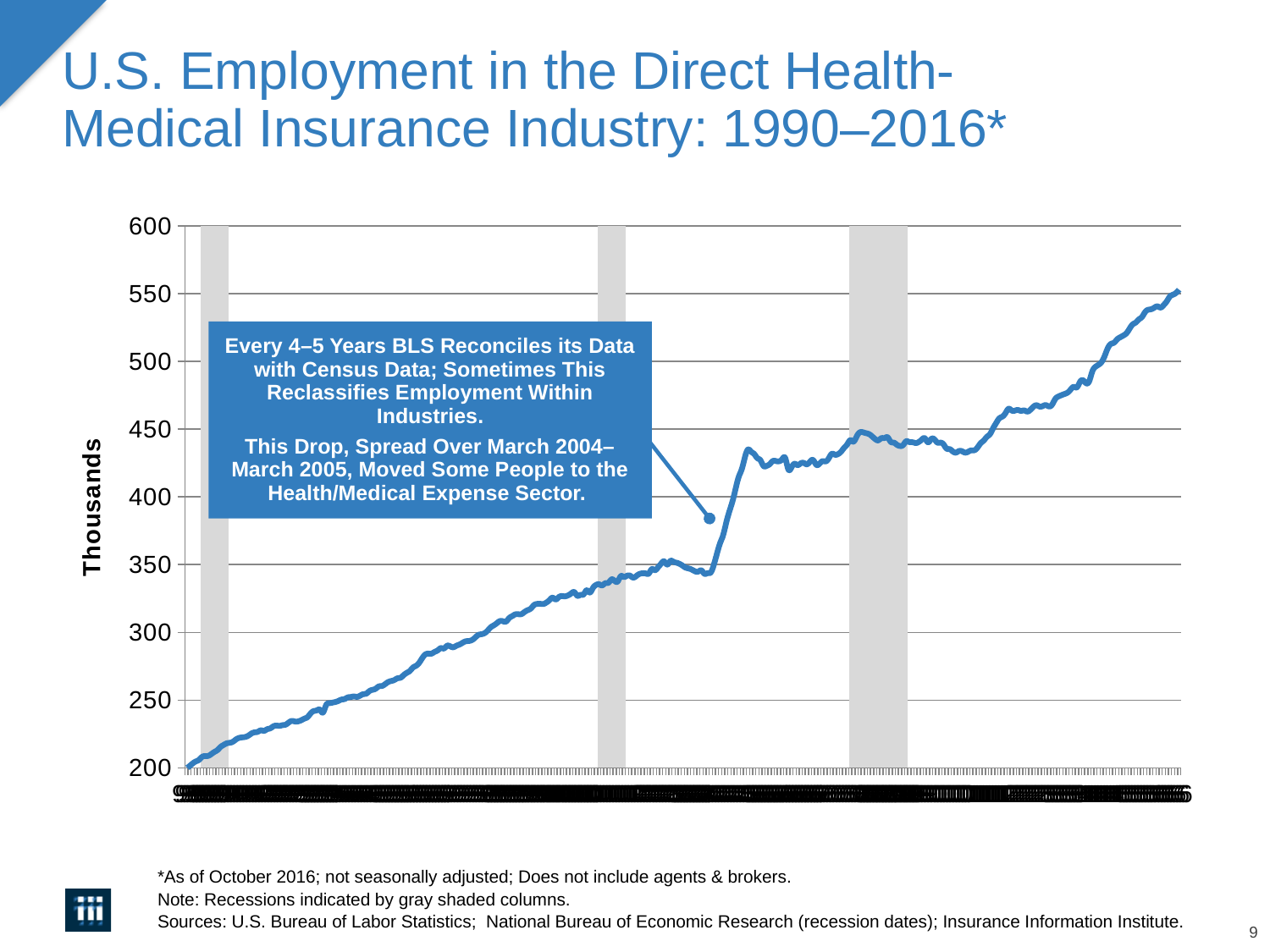
Overall, do the values rise or fall from the left to the right of the chart? rise Is the value at the point marked by the annotation arrow (the drop in 2004–2005) greater or less than 450? less How many gray shaded recession columns are shown on the chart? 3 What is the highest value shown on the vertical axis of the chart? 600 Is the value at the end of the line (right end) greater or less than 500? greater Is the value at the point marked by the annotation arrow (the drop in 2004–2005) greater or less than 350? greater What kind of chart is shown on the slide? line chart Is the lowest point of the line at the left end or the right end of the chart? left end Is the highest point of the line at the left end or the right end of the chart? right end What is the title of the chart on the slide? U.S. Employment in the Direct Health-Medical Insurance Industry: 1990–2016* What is the label on the vertical axis of the chart? Thousands